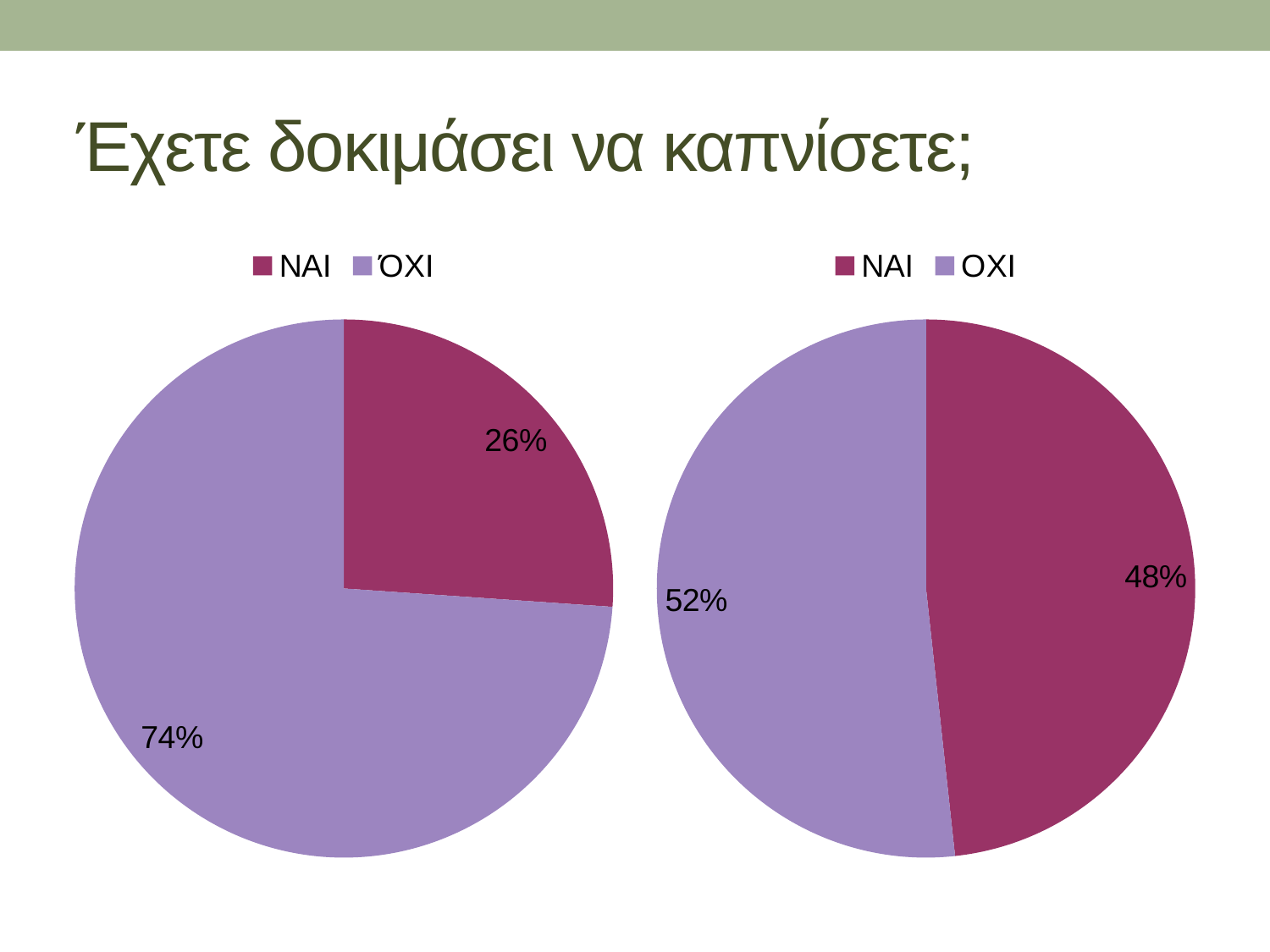
Is the ΝΑΙ share larger in the left pie chart or the right pie chart? right In the right pie chart, what percentage is shown for ΟΧΙ? 52% What type of chart is the left chart on the slide? pie chart In the left pie chart, what is the difference in percentage points between ΌΧΙ and ΝΑΙ? 48 How many entries does the legend of the left pie chart list? 2 How many slices does the right pie chart have? 2 In the right pie chart, which category has the smallest slice? ΝΑΙ In the left pie chart, what percentage is shown for ΝΑΙ? 26% In the left pie chart, which category has the largest slice? ΌΧΙ In the right pie chart, what is the difference in percentage points between ΟΧΙ and ΝΑΙ? 4 In the right pie chart, what percentage is shown for ΝΑΙ? 48% In the left pie chart, what percentage is shown for ΌΧΙ? 74%